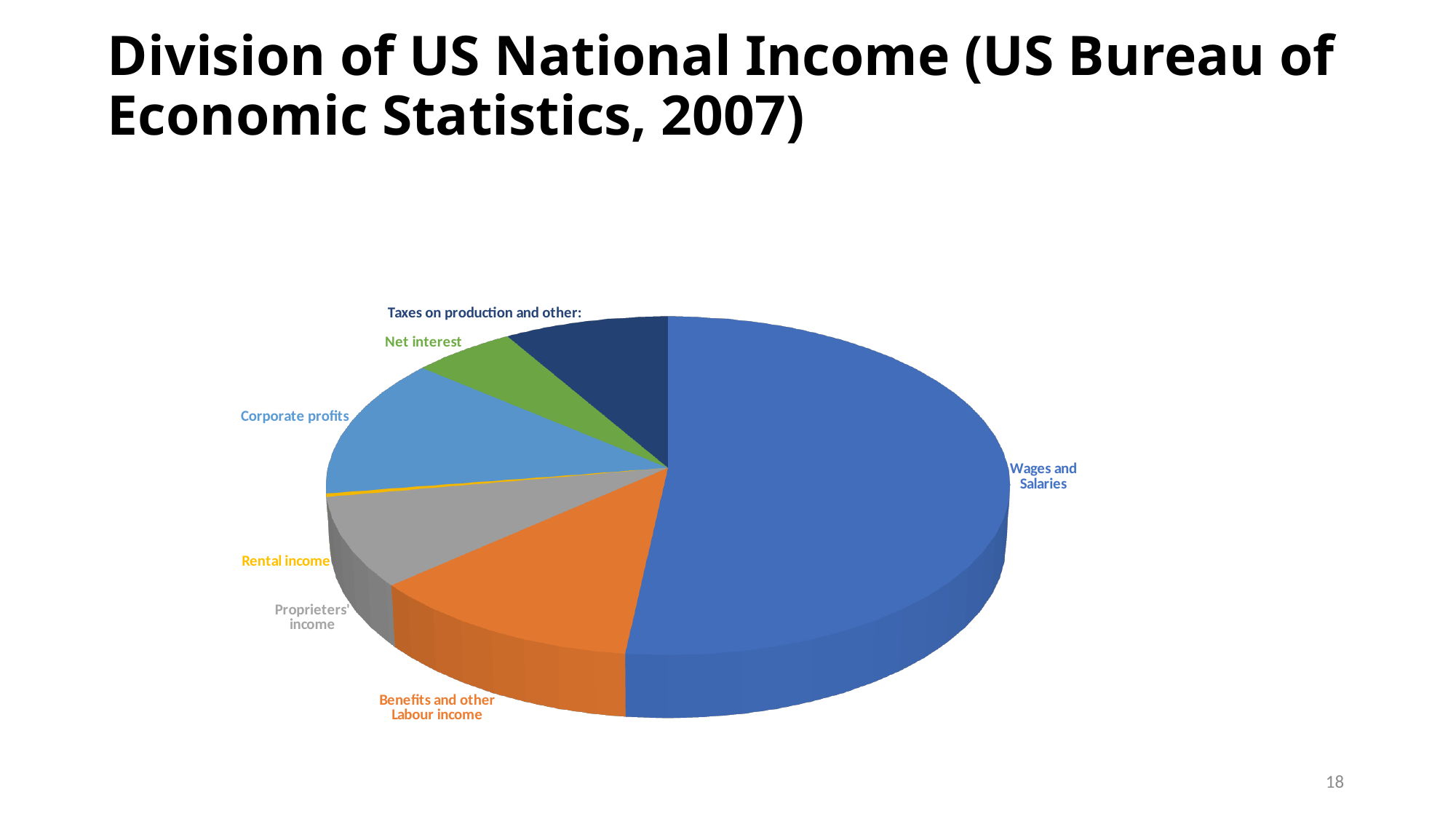
Which category has the largest slice of the pie? Wages and Salaries Which slice is larger: Benefits and other Labour income or Proprieters' income? Benefits and other Labour income Which category has the smallest slice of the pie? Rental income Which slice is larger: Taxes on production and other or Rental income? Taxes on production and other What kind of chart is shown on the slide? Pie chart Which slice is larger: Corporate profits or Proprieters' income? Corporate profits What colour is the Net interest slice? Green What is the title of the slide containing the pie chart? Division of US National Income (US Bureau of Economic Statistics, 2007) How many slices does the pie chart have? 7